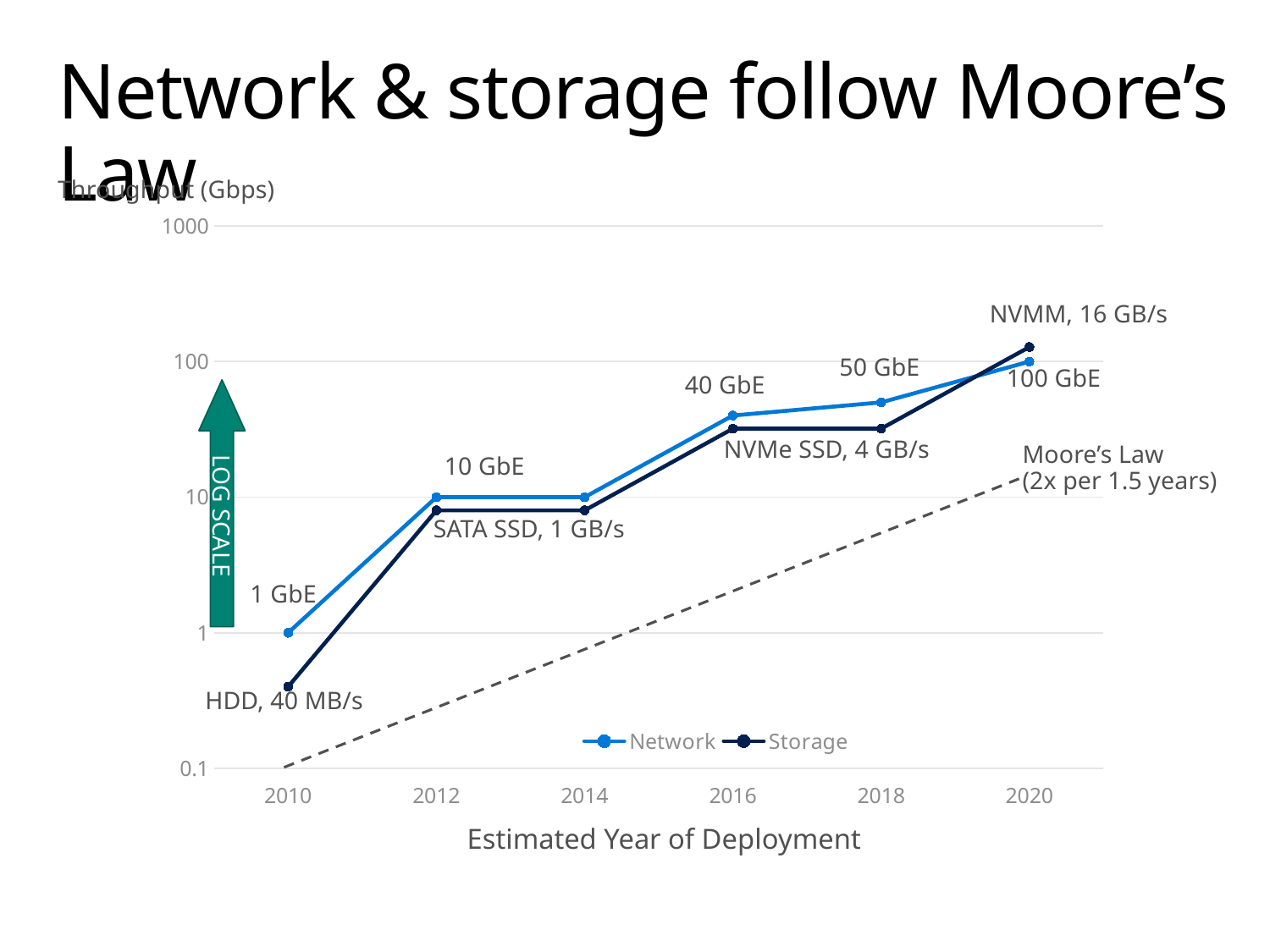
How many years are marked on the x axis? 6 What label is attached to the Network point at 2018? 50 GbE In which year does the Network series reach its highest value? 2020 What type of chart is shown on the slide? line chart In which year is the Storage series at its lowest value? 2010 What is the title of the x axis? Estimated Year of Deployment How many series does the legend list? 2 What label is attached to the Storage point at 2010? HDD, 40 MB/s At 2020, which series has the higher throughput, Network or Storage? Storage What label is attached to the Storage point at 2020? NVMM, 16 GB/s Is the Storage value at 2010 greater or less than 1 Gbps? less What label is attached to the Network point at 2016? 40 GbE